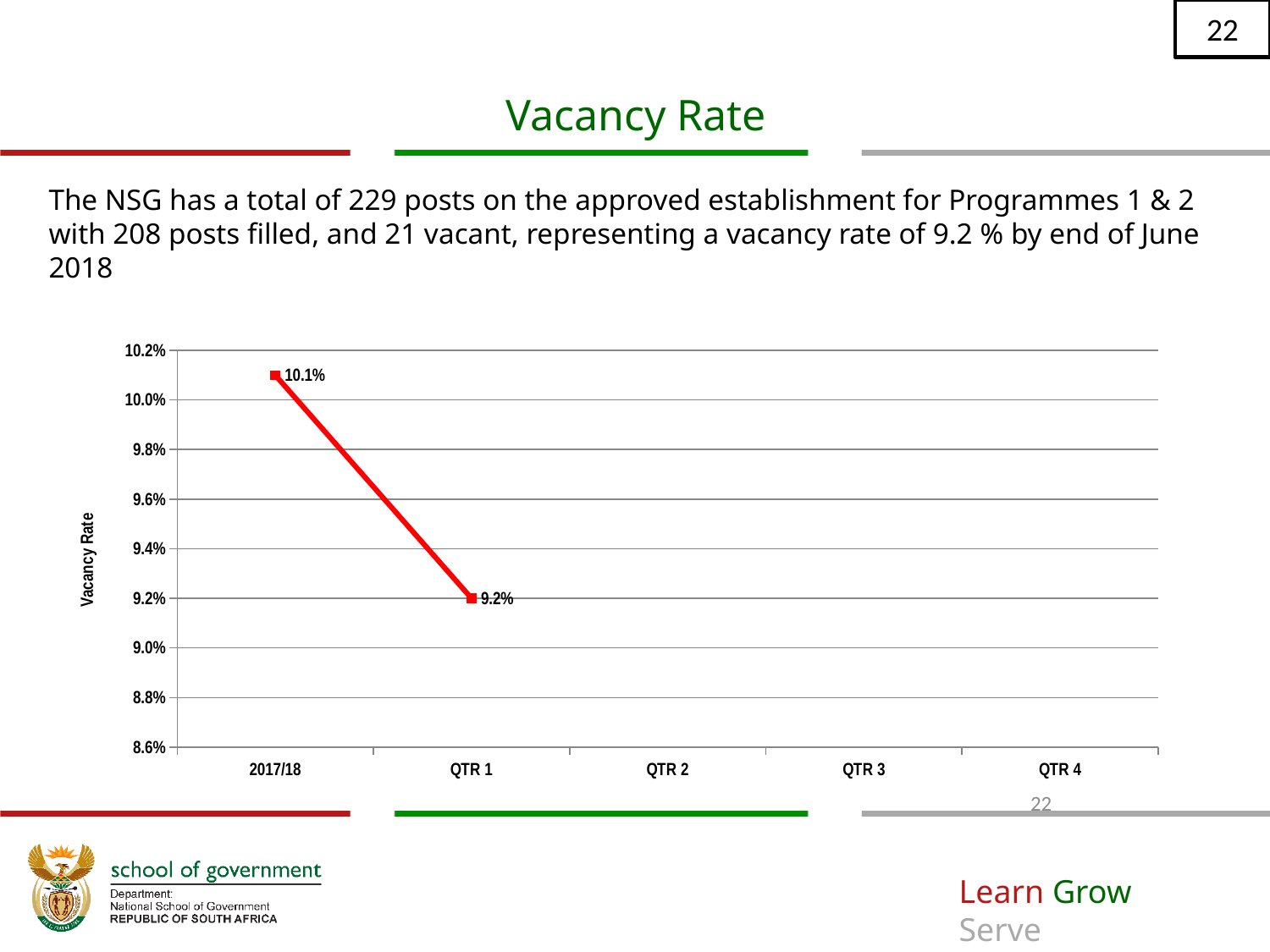
Does the vacancy rate rise or fall from 2017/18 to QTR 1? Fall Which plotted point has the lowest vacancy rate? QTR 1 What kind of chart is shown on the slide? Line chart How many data points are plotted on the chart? 2 Is the vacancy rate for 2017/18 greater or less than 10.0%? greater What is the vacancy rate for QTR 1? 9.2% Which plotted point has the highest vacancy rate? 2017/18 How many categories are shown on the x axis of the chart? 5 What is the vacancy rate for 2017/18? 10.1% What is the difference between the vacancy rate for 2017/18 and for QTR 1? 0.9% Is the vacancy rate for QTR 1 greater or less than 9.4%? less Which is larger, the vacancy rate for 2017/18 or for QTR 1? 2017/18